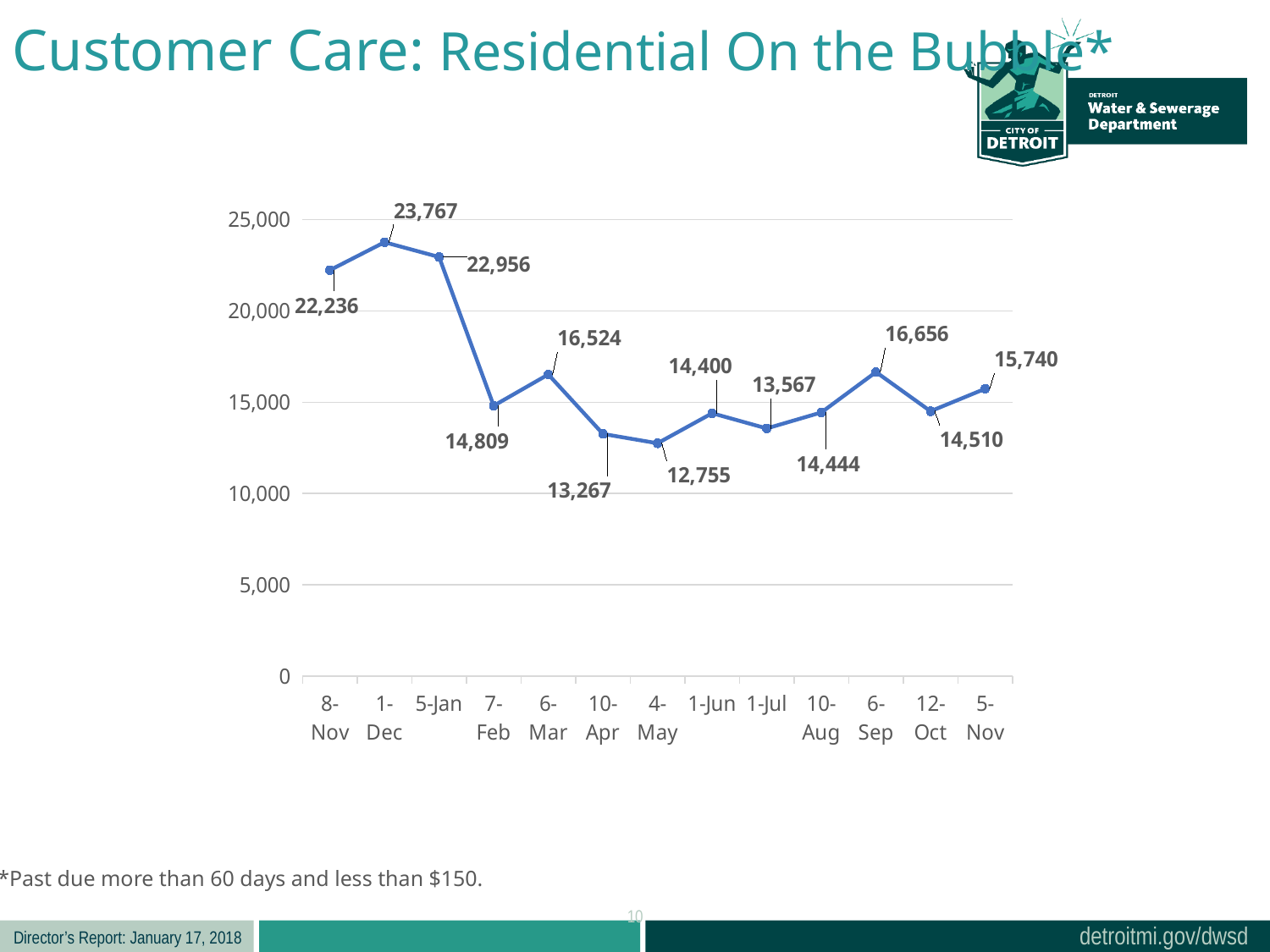
Which date has the highest value? 1-Dec What is the value for 4-May? 12,755 What is the value for 1-Dec? 23,767 Is the value for 8-Nov greater or less than 20,000? greater Which is larger, the value for 6-Mar or the value for 10-Apr? 6-Mar Does the value rise or fall from 5-Jan to 7-Feb? fall Which date has the lowest value? 4-May What is the value for 5-Nov? 15,740 What is the value for 6-Sep? 16,656 What type of chart is shown on the slide? line chart What is the difference between the values for 5-Jan and 7-Feb? 8,147 How many data points are plotted on the chart? 13